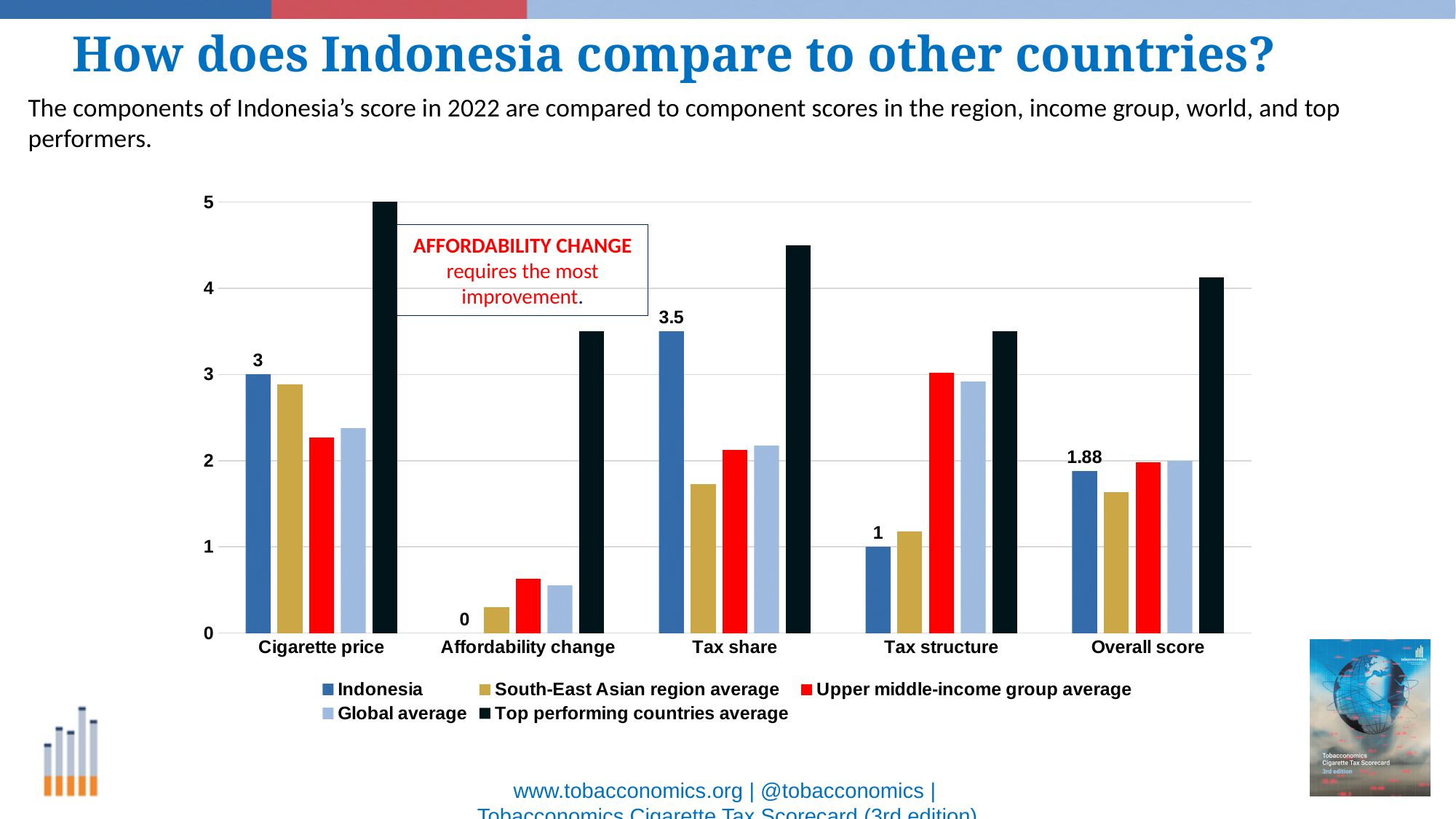
In which category does Indonesia have its lowest value? Affordability change What is Indonesia's Overall score? 1.88 What is Indonesia's value for Tax share? 3.5 How many series does the legend list? 5 What is Indonesia's value for Affordability change? 0 In which category does Indonesia have its highest value? Tax share For Cigarette price, which is larger: Indonesia or the Top performing countries average? Top performing countries average What is Indonesia's value for Cigarette price? 3 How many categories are shown on the x axis? 5 What kind of chart is shown on the slide? bar chart Is the Top performing countries average for Tax share greater or less than 4? greater What is the difference between Indonesia's Tax share value and its Cigarette price value? 0.5